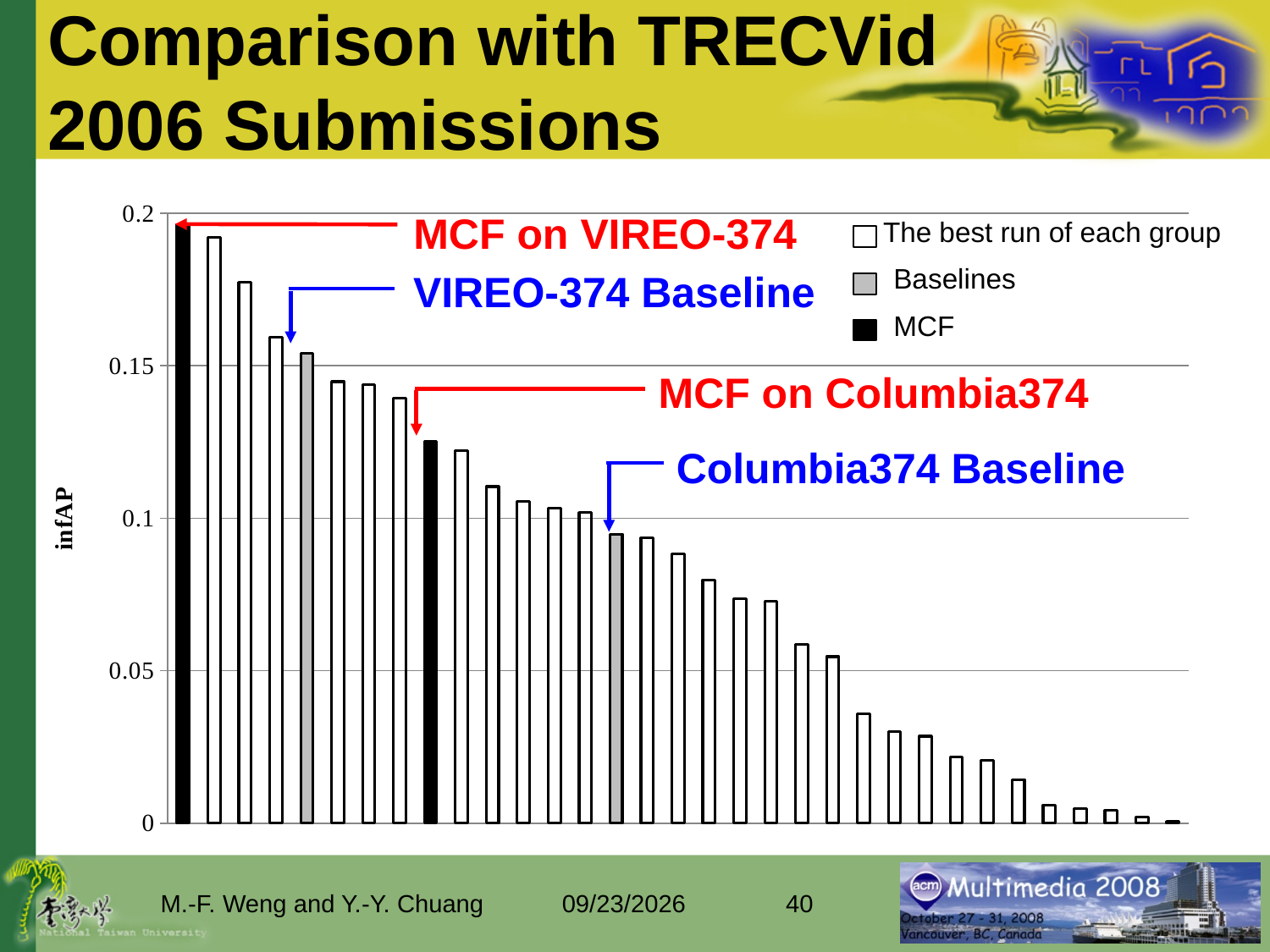
Which is larger, MCF on VIREO-374 or VIREO-374 Baseline? MCF on VIREO-374 Is the value for VIREO-374 Baseline greater or less than 0.1? greater What is the label on the y axis? infAP What kind of chart is shown on the slide? bar chart Is the value for Columbia374 Baseline greater or less than 0.15? less Of the four annotated bars, which has the highest infAP? MCF on VIREO-374 Do the bar values rise or fall from left to right along the x axis? fall How many series does the legend list? 3 Which colour does the legend use for MCF? black Is the value for MCF on VIREO-374 greater or less than 0.15? greater Which is larger, MCF on Columbia374 or Columbia374 Baseline? MCF on Columbia374